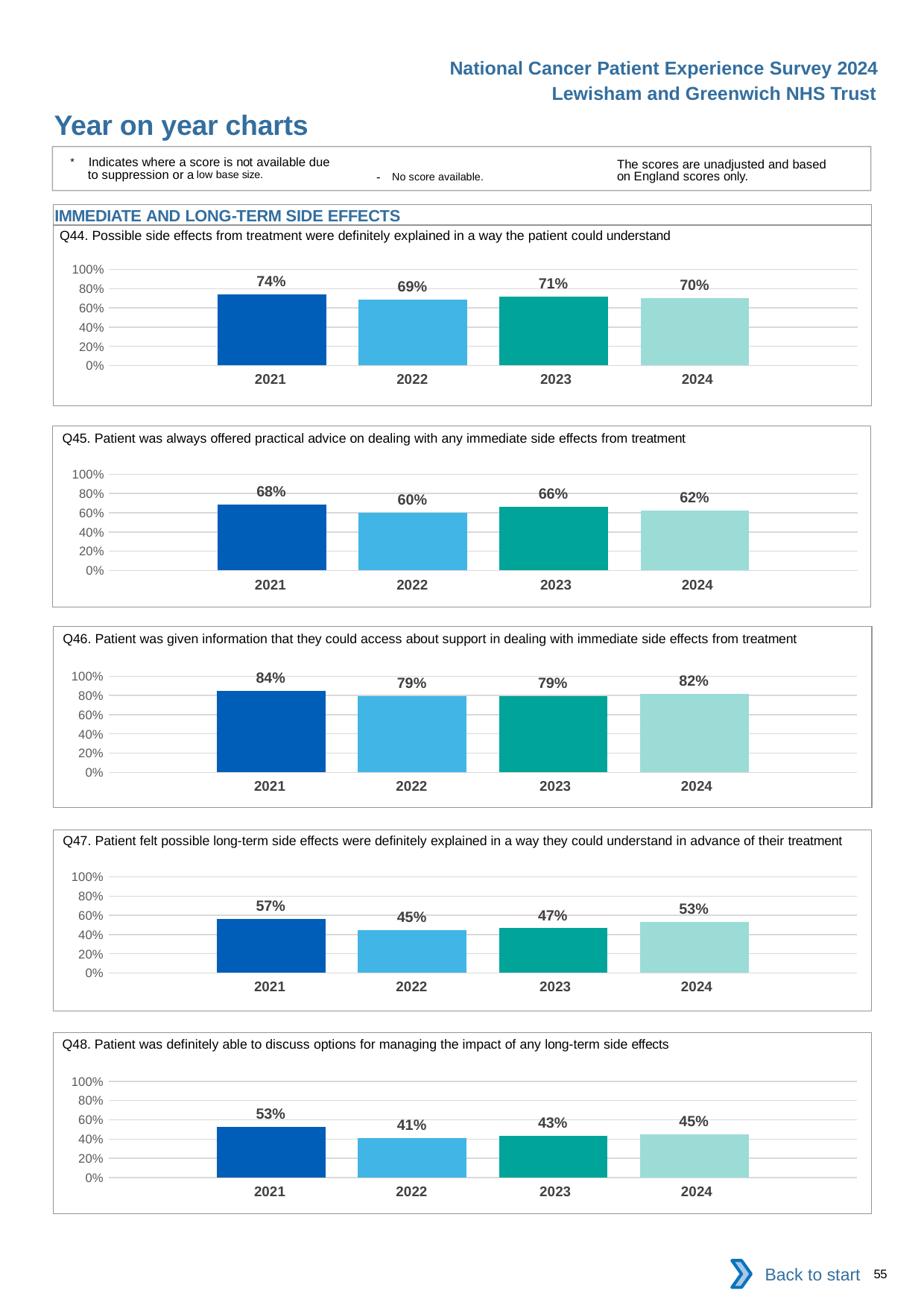
In the Q47 chart, is the value for 2024 larger than the value for 2022? Yes In the Q45 chart, what is the value for 2024? 62% How many years are shown in the Q45 chart? 4 In the Q44 chart, what is the difference between the 2021 and 2022 values? 5% In the Q48 chart, is the value for 2021 greater or less than 40%? greater In the Q45 chart, which year has the lowest value? 2022 In the Q44 chart, what is the value for 2021? 74% In the Q48 chart, what is the value for 2023? 43% In the Q46 chart, what is the difference between the 2021 and 2024 values? 2% What is the section heading above the Q44 chart? IMMEDIATE AND LONG-TERM SIDE EFFECTS In the Q47 chart, which year has the highest value? 2021 What kind of chart is the Q46 chart? Bar chart